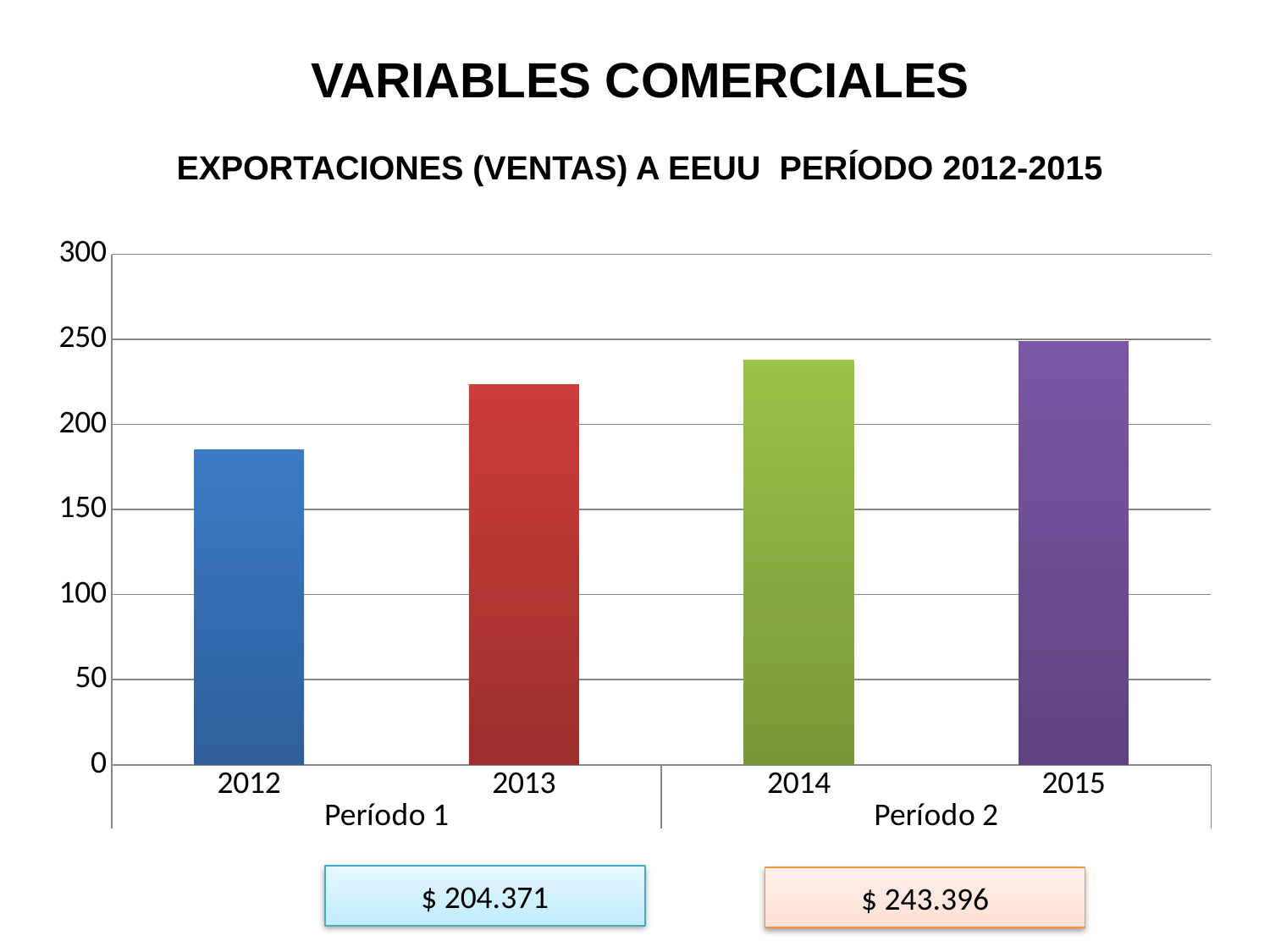
How many bars (years) are plotted in the chart? 4 Do the values rise or fall from 2012 to 2015? rise Is the value for 2012 greater or less than 150? greater Is the value for 2012 greater or less than 200? less What kind of chart is shown on the slide? bar chart Which year has the highest bar in the chart? 2015 What is the title of the chart? EXPORTACIONES (VENTAS) A EEUU PERÍODO 2012-2015 Is the value for 2013 greater or less than 200? greater Which is larger, the value for 2012 or the value for 2013? 2013 Which year has the lowest bar in the chart? 2012 Which years are grouped under Período 2 on the x axis? 2014 and 2015